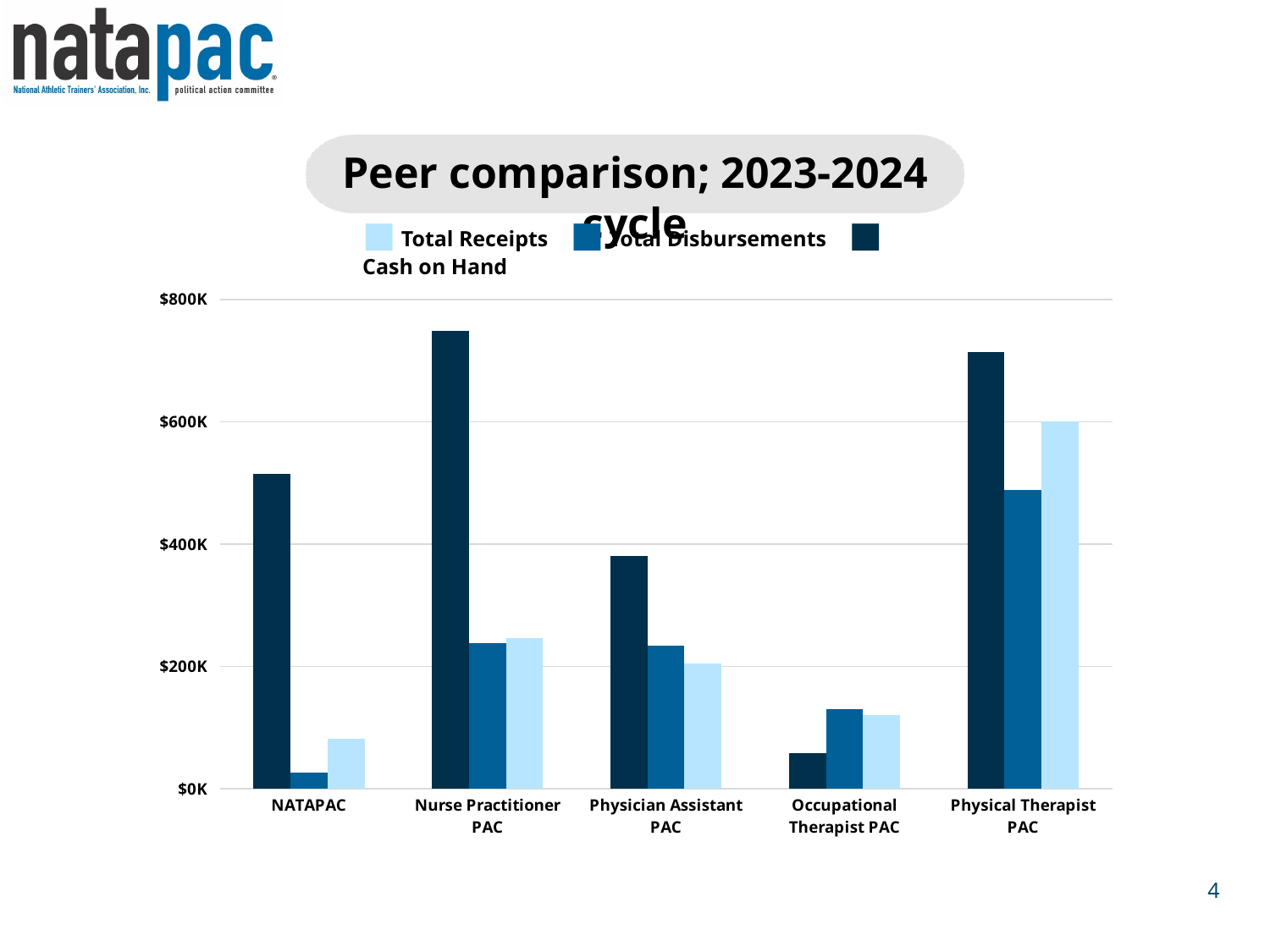
Is the Total Receipts value for Occupational Therapist PAC greater or less than $200K? less Is the Cash on Hand value for NATAPAC greater or less than $400K? greater What kind of chart is shown on the slide? Bar chart Which PAC has the lowest Total Disbursements? NATAPAC Which PAC has the highest Cash on Hand? Nurse Practitioner PAC How many series does the chart's legend list? 3 Is the Cash on Hand value for Nurse Practitioner PAC greater or less than $600K? greater Which PAC has the lowest Cash on Hand? Occupational Therapist PAC Which PAC has the highest Total Receipts? Physical Therapist PAC How many PACs (categories) are shown on the x axis of the chart? 5 What is the title of the chart? Peer comparison; 2023-2024 cycle For Physician Assistant PAC, which is larger: Cash on Hand or Total Receipts? Cash on Hand